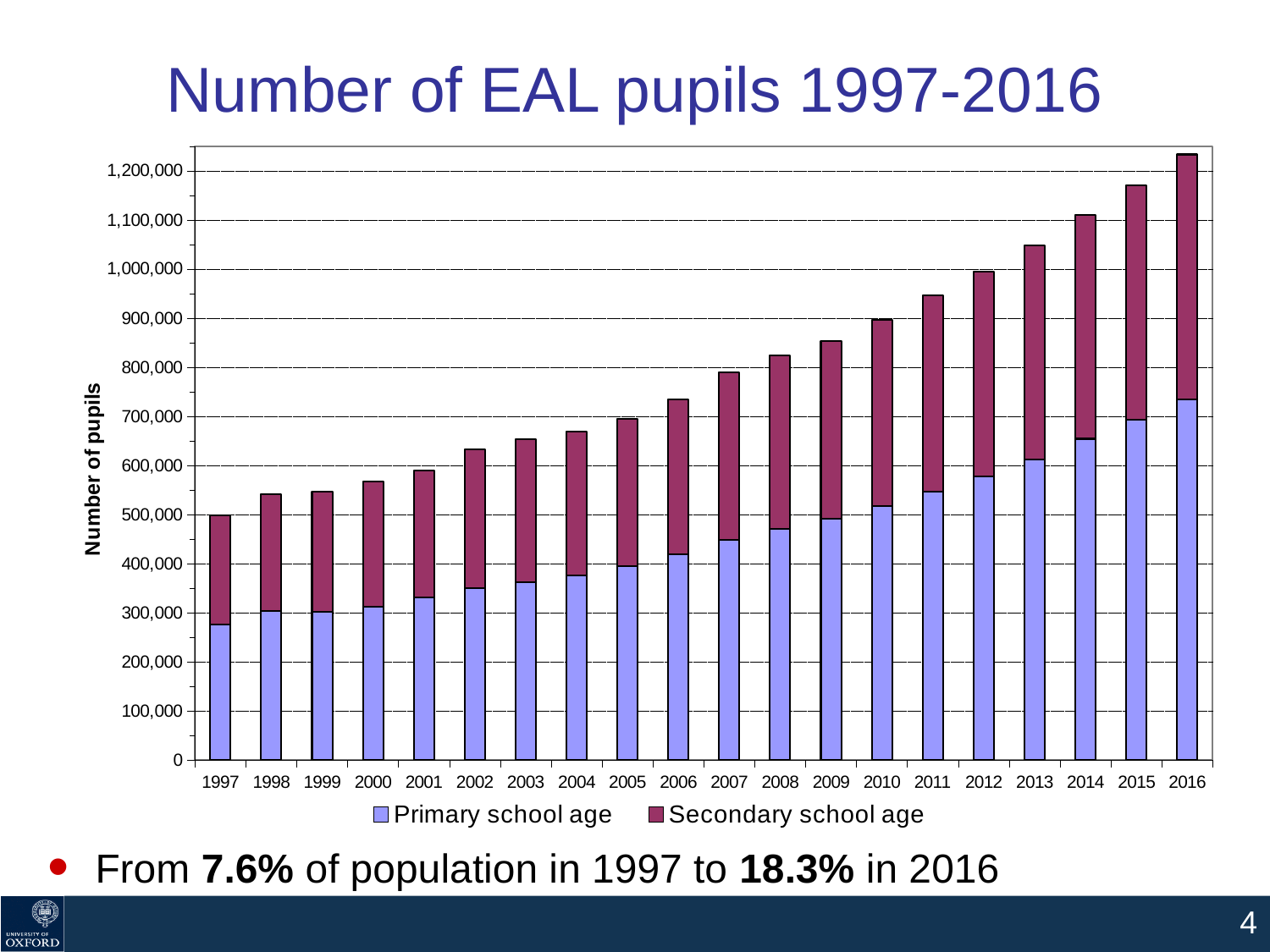
In 2016, which is larger: the number of primary school age pupils or the number of secondary school age pupils? Primary school age Do the total numbers of EAL pupils rise or fall from 1997 to 2016? Rise Which year has the highest total number of EAL pupils? 2016 How many series does the chart's legend list? 2 Is the number of primary school age EAL pupils in 1997 greater or less than 300,000? less Which year has the lowest total number of EAL pupils? 1997 What kind of chart is shown on the slide? Stacked bar chart Is the total number of EAL pupils in 2016 greater or less than 1,200,000? greater Is the number of primary school age EAL pupils in 2016 greater or less than 700,000? greater What is the title of the chart's vertical axis? Number of pupils How many years are shown along the x axis of the chart? 20